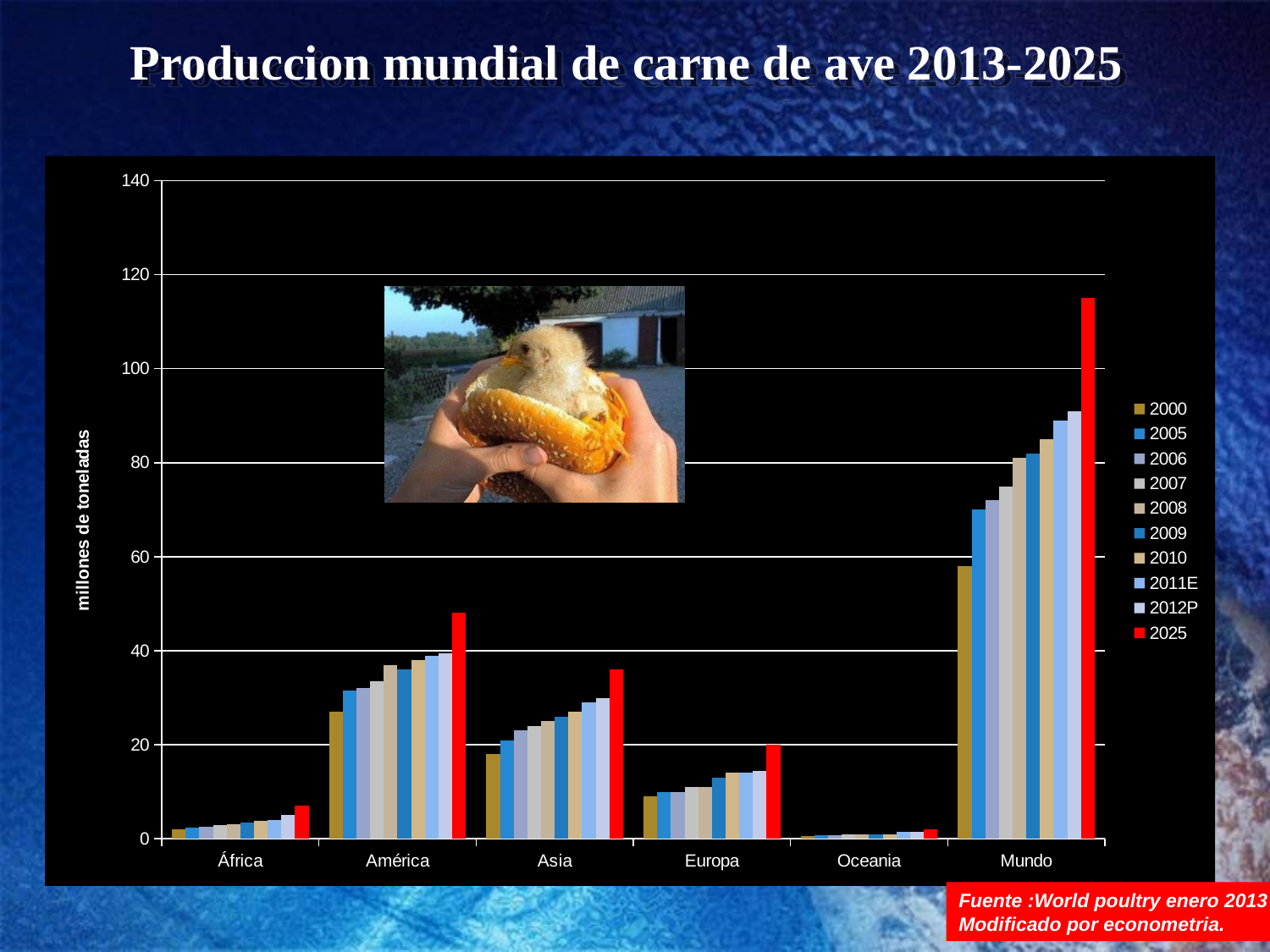
Is the 2025 value for Mundo greater or less than 100? greater Is the 2000 value for Mundo greater or less than 40? greater How many series does the legend of the chart list? 10 What kind of chart is shown on the slide? bar chart What is the label of the y axis of the chart? millones de toneladas Is the 2025 value for Asia greater or less than 40? less Which category has the lowest bars in the chart? Oceania How many categories are shown on the x axis of the chart? 6 Within the Mundo category, do the values rise or fall from the 2000 series to the 2025 series? rise Which category has the highest bars in the chart? Mundo Which is larger, the 2025 value for América or the 2025 value for Asia? América